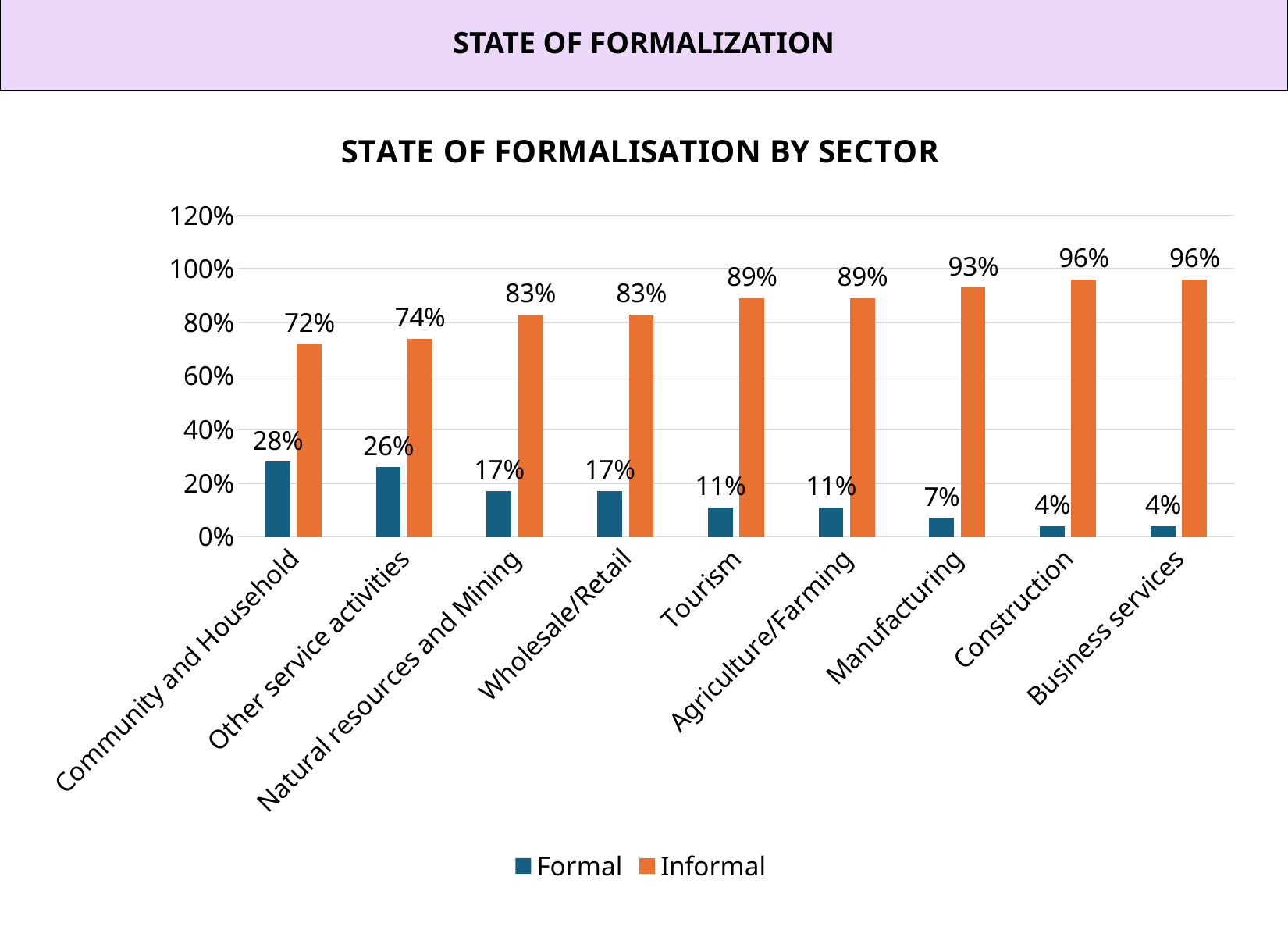
Which is larger, the Formal value for Other service activities or the Formal value for Wholesale/Retail? Other service activities What is the difference between the Informal and Formal values for Tourism? 78% How many series does the legend list? 2 Which sector has the highest Formal value? Community and Household What is the Informal value for Other service activities? 74% Do the Formal values rise or fall from left to right along the x axis? Fall How many sectors are shown on the x axis? 9 What kind of chart is shown? Bar chart What is the Informal value for Manufacturing? 93% What is the title of the chart? STATE OF FORMALISATION BY SECTOR Which sector has the lowest Informal value? Community and Household What is the Formal value for Community and Household? 28%